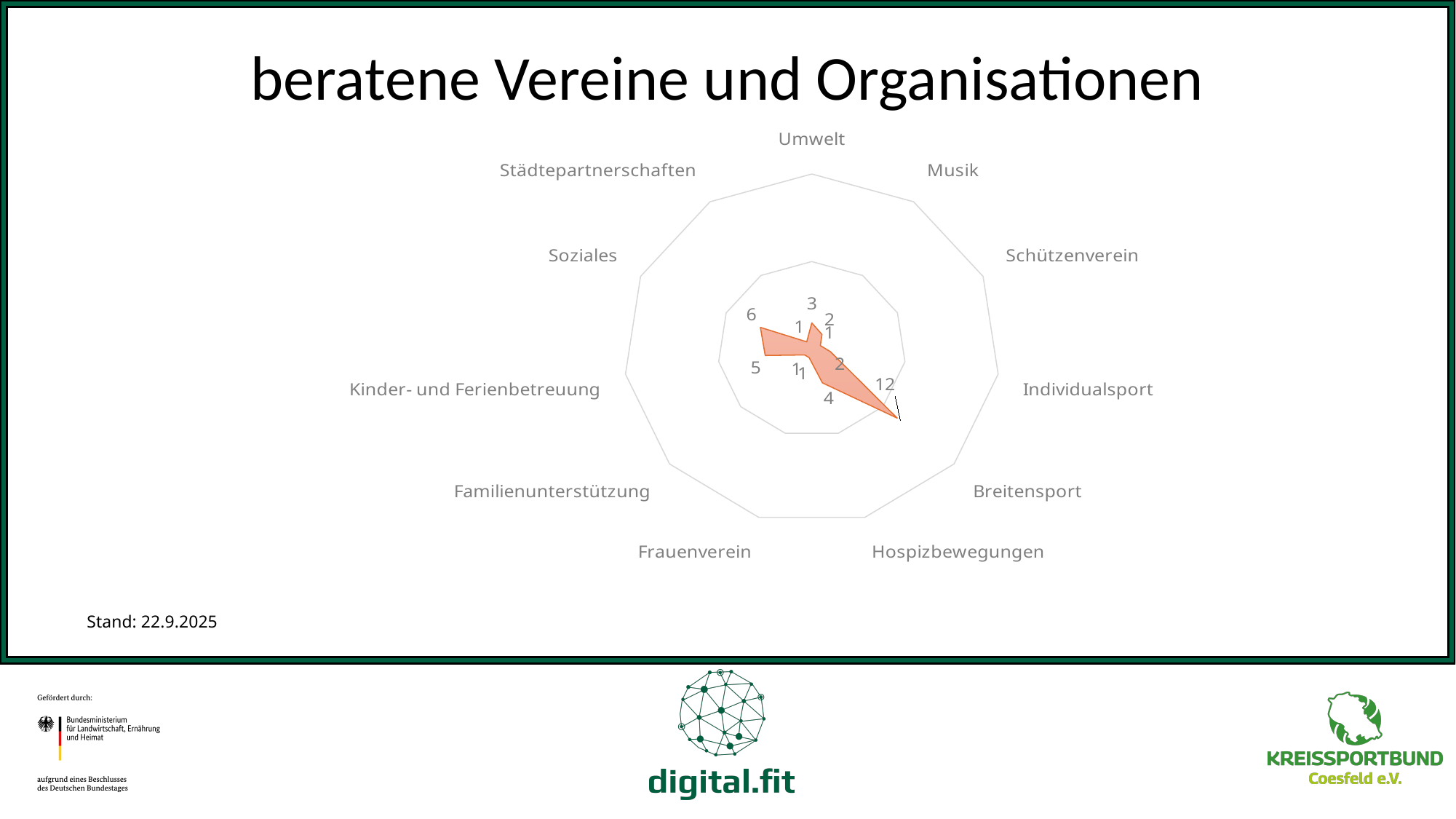
What is the title of the chart on the slide? beratene Vereine und Organisationen What kind of chart is shown on the slide? Radar chart What is the value for Hospizbewegungen? 4 What is the value for Umwelt? 3 What date is given as the 'Stand' (status date) on the slide? 22.9.2025 What is the difference between the values for Breitensport and Soziales? 6 How many categories are plotted on the radar chart? 11 Which category has the highest value on the radar chart? Breitensport What is the value for Breitensport? 12 What is the value for Kinder- und Ferienbetreuung? 5 Which has a larger value, Soziales or Hospizbewegungen? Soziales What is the value for Soziales? 6